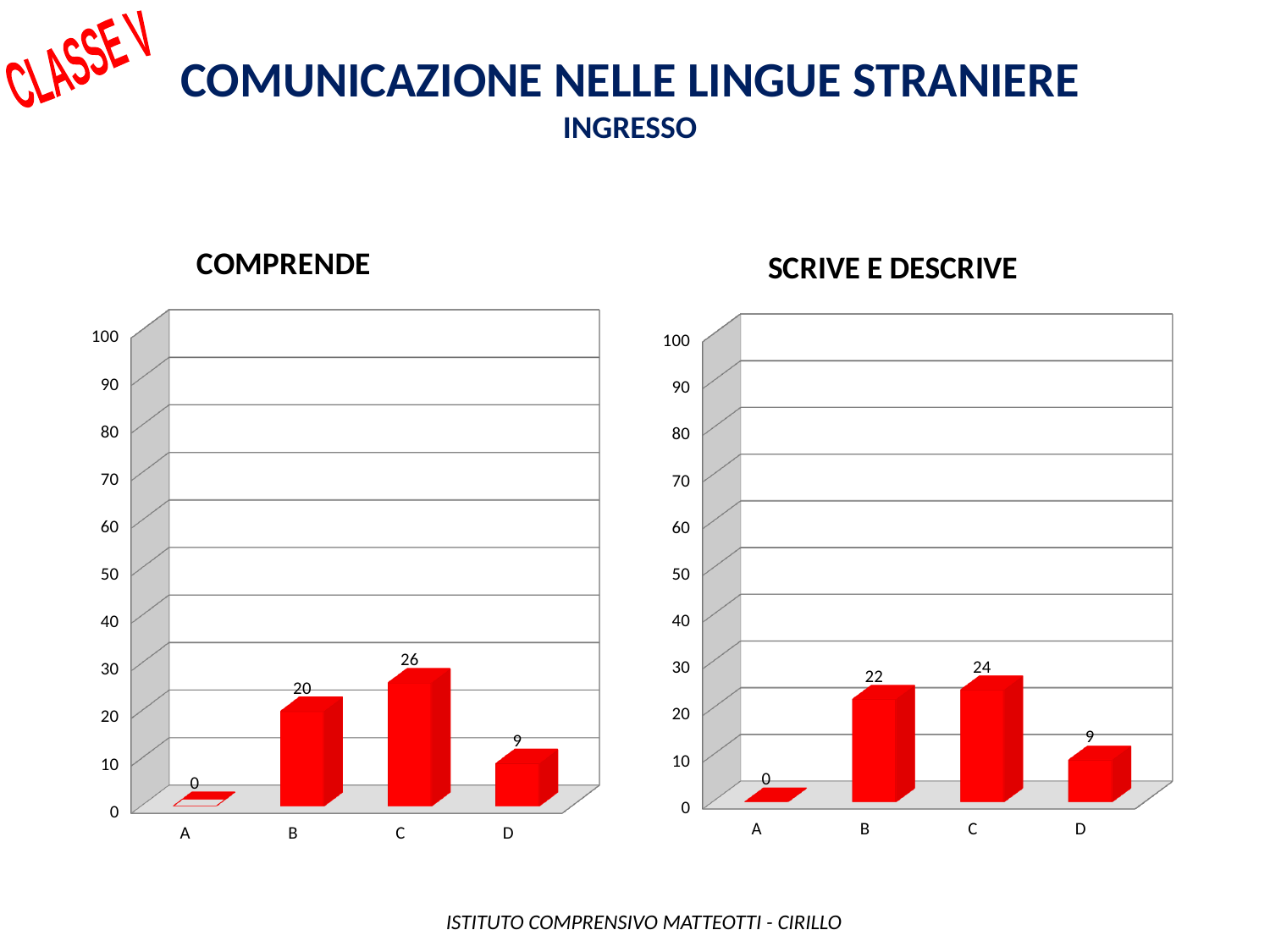
In the COMPRENDE chart, what is the difference between the values for C and B? 6 In the SCRIVE E DESCRIVE chart, which category has the lowest value? A In the SCRIVE E DESCRIVE chart, what is the value for category B? 22 In the SCRIVE E DESCRIVE chart, what is the difference between the values for C and D? 15 In the SCRIVE E DESCRIVE chart, is the value for C greater or less than 30? less In the COMPRENDE chart, which category has the highest value? C What kind of chart is the SCRIVE E DESCRIVE chart? bar chart In the COMPRENDE chart, what is the value for category A? 0 What is the title of the chart on the right side of the slide? SCRIVE E DESCRIVE In the COMPRENDE chart, which is larger, the value for B or the value for D? B In the COMPRENDE chart, what is the value for category C? 26 How many categories are shown in the COMPRENDE chart? 4